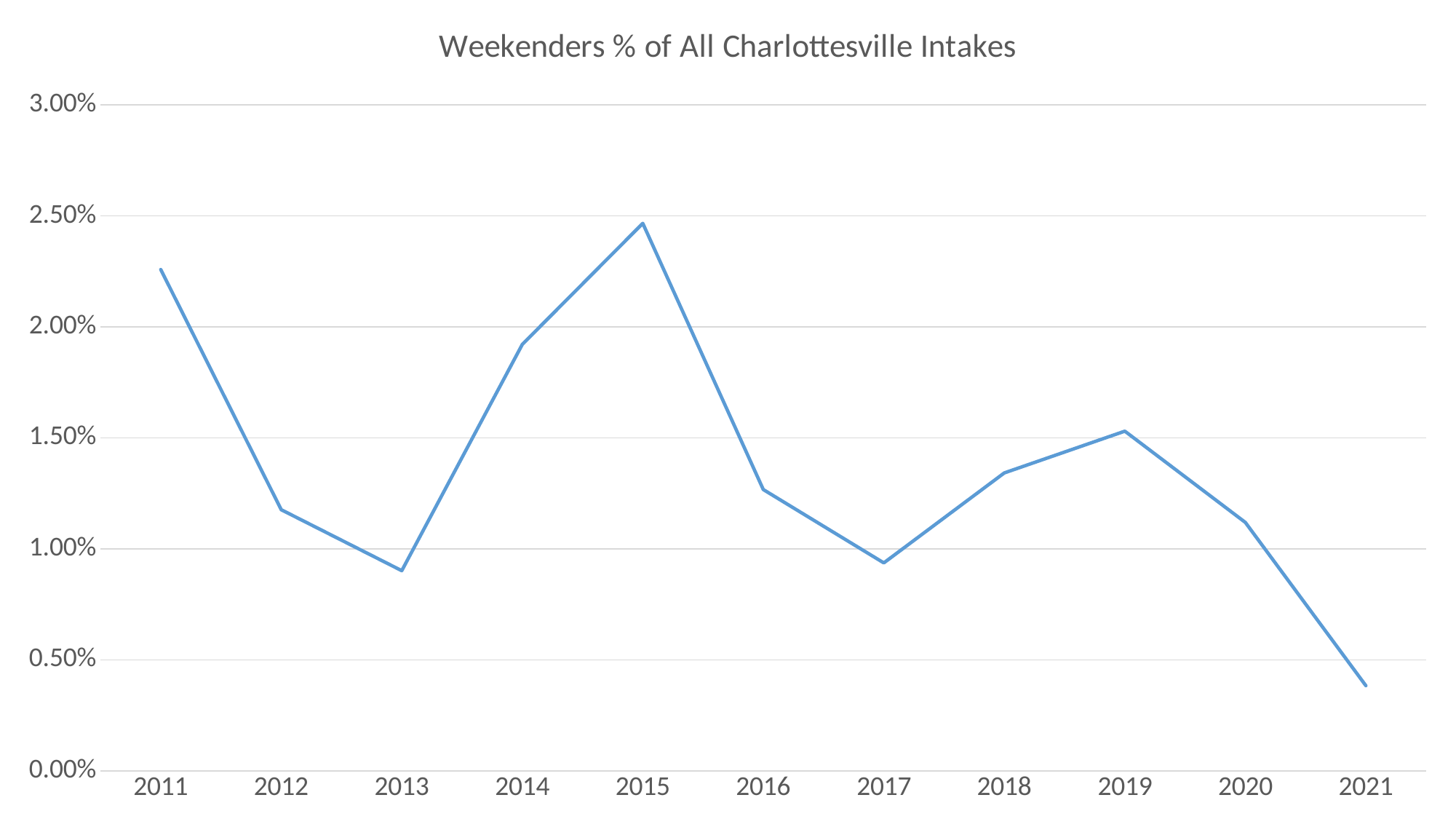
Which year has the highest value? 2015 What is the title of the chart? Weekenders % of All Charlottesville Intakes Which year has the lowest value? 2021 Which is larger, the value for 2011 or the value for 2012? 2011 Is the value for 2021 greater or less than 0.50%? less Which is larger, the value for 2019 or the value for 2017? 2019 Is the value for 2013 greater or less than 1.00%? less Do the values rise or fall from 2019 to 2021? fall Is the value for 2015 greater or less than 2.00%? greater How many years are plotted on the x axis? 11 What type of chart is shown on the slide? line chart